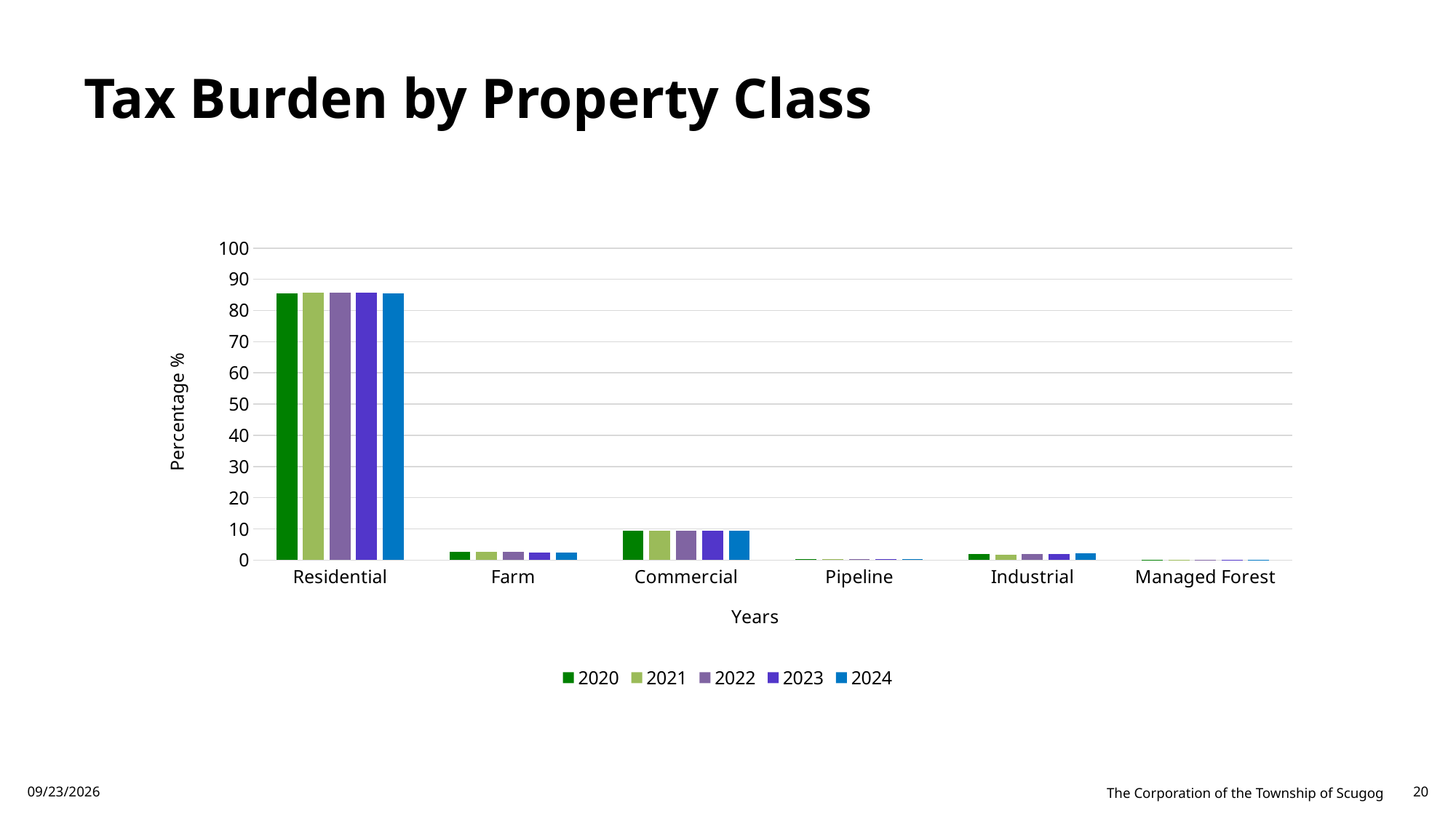
Is the value for Industrial in 2023 greater or less than 10? less Which has a larger value in 2020, Residential or Commercial? Residential How many series does the legend list? 5 Which has a larger value in 2021, Commercial or Farm? Commercial What is the label on the vertical axis? Percentage % Which property class has the highest tax burden percentage? Residential Is the value for Farm in 2022 greater or less than 10? less How many property class categories are shown on the x axis? 6 What kind of chart is shown on the slide? bar chart Is the value for Residential in 2024 greater or less than 80? greater What is the title of the chart? Tax Burden by Property Class